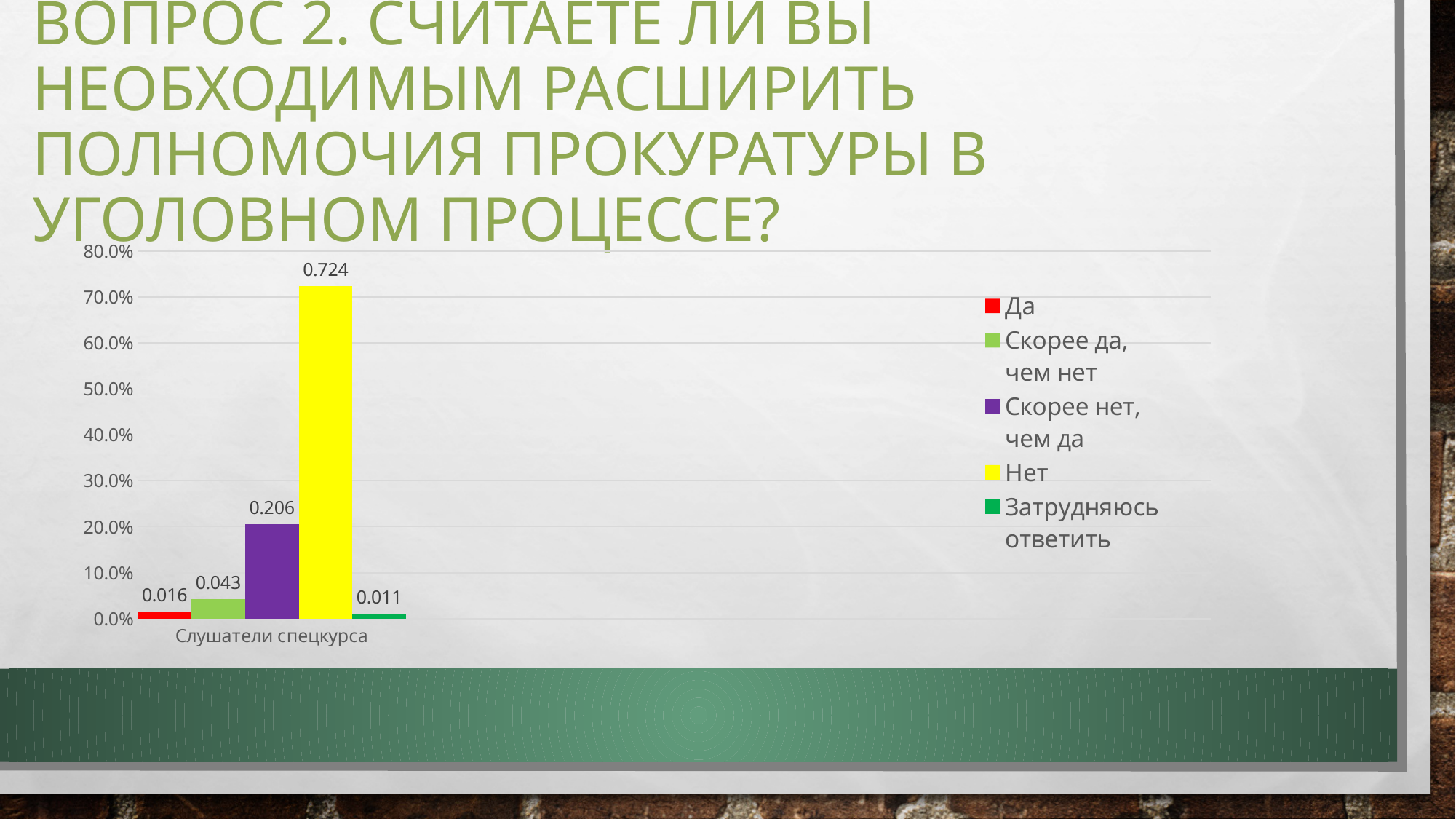
Which series has the highest bar? Нет Which series has the lowest bar? Затрудняюсь ответить What is the category label shown on the x axis? Слушатели спецкурса What is the data label on the bar for "Скорее нет, чем да"? 0.206 Is the bar for "Нет" greater or less than 70.0% on the axis? greater How many series does the legend list? 5 What is the data label on the bar for "Да"? 0.016 What is the data label on the bar for "Нет"? 0.724 What is the difference between the data labels for "Нет" and "Скорее нет, чем да"? 0.518 Which is larger, the value for "Скорее да, чем нет" or the value for "Да"? Скорее да, чем нет What kind of chart is shown on the slide? bar chart What is the data label on the bar for "Затрудняюсь ответить"? 0.011